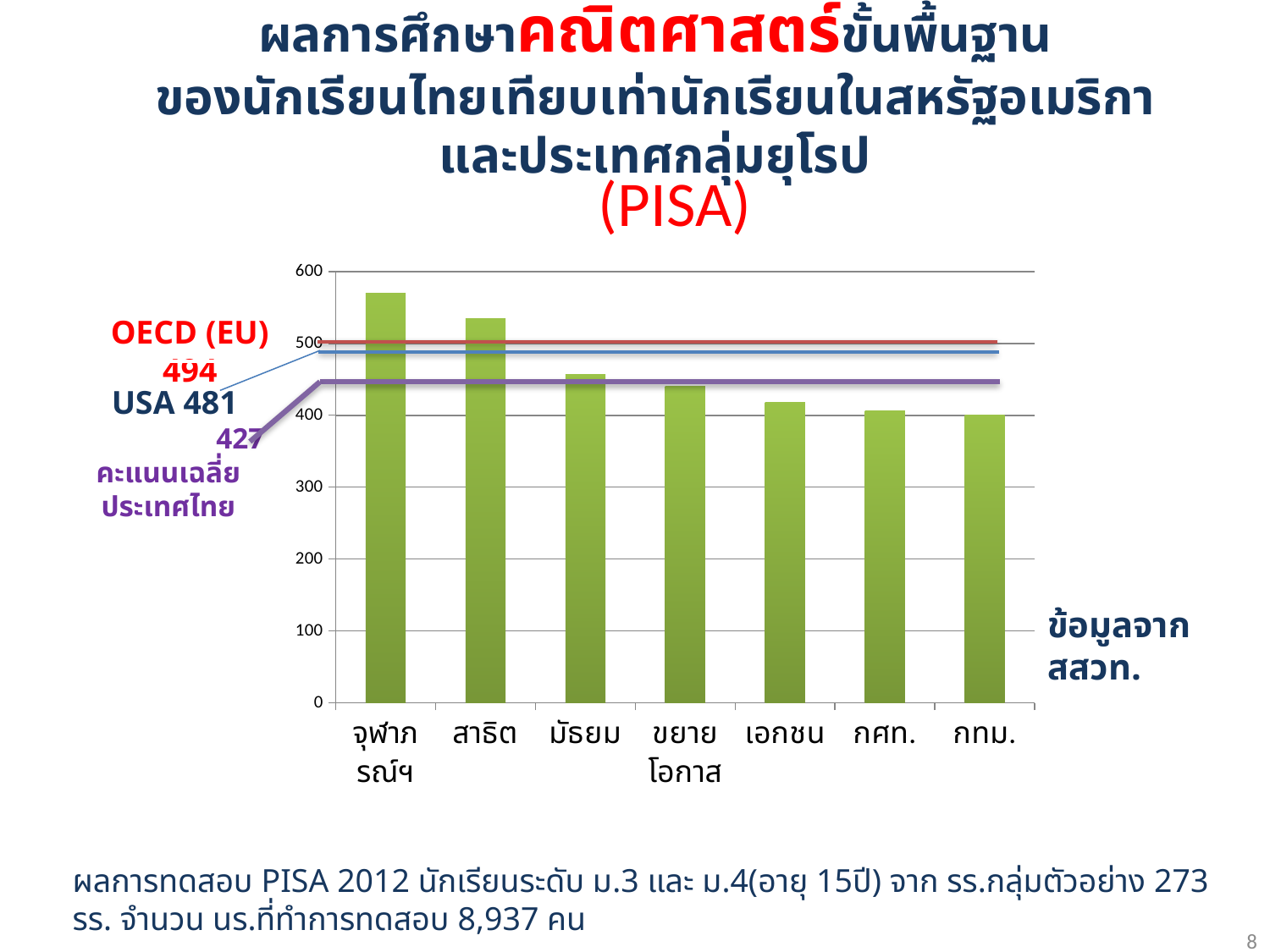
What kind of chart is shown on the slide? bar chart Which category has the highest bar? จุฬาภรณ์ฯ Is the value for มัธยม greater or less than 500? less Which is larger, the value for สาธิต or the value for เอกชน? สาธิต Is the value for ขยายโอกาส greater or less than 400? greater How many categories (school groups) are plotted on the x axis? 7 Which category has the lowest bar? กทม. Do the bar values rise or fall from left to right along the x axis? fall What OECD (EU) score is marked by the red reference line? 494 What is the Thai national average score (คะแนนเฉลี่ยประเทศไทย) marked by the purple reference line? 427 What USA score is marked by the blue reference line? 481 Is the value for จุฬาภรณ์ฯ greater or less than 500? greater